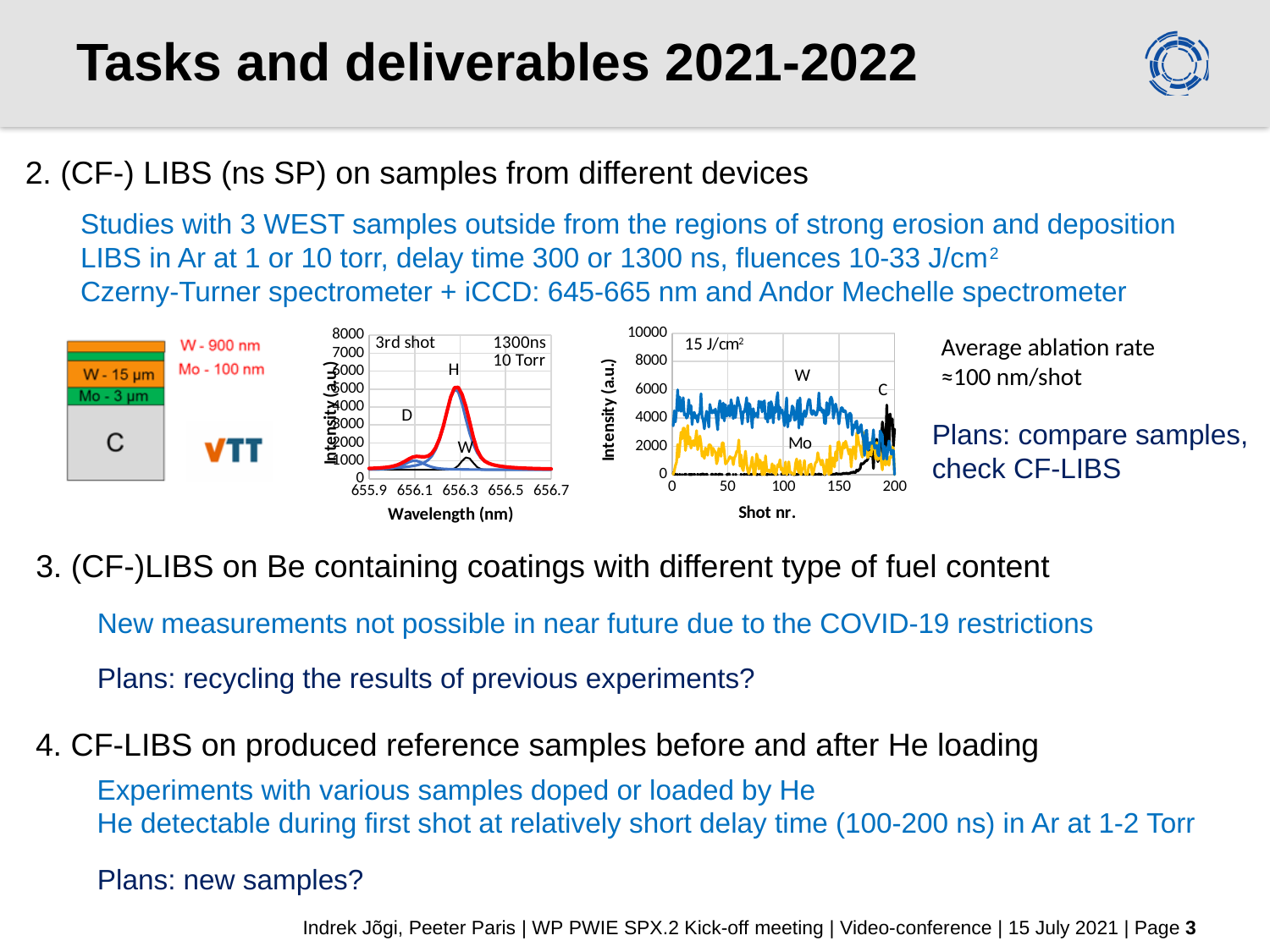
In the left chart (Intensity vs Wavelength), which labelled peak is the highest? H What kind of chart is the right chart (Intensity vs Shot nr.)? line chart In the left chart (Intensity vs Wavelength), is the peak value for W greater or less than 2000? less In the right chart (Intensity vs Shot nr.), is the value for W at shot 50 greater or less than 2000? greater In the right chart (Intensity vs Shot nr.), is the value for C at shot 50 greater or less than 2000? less In the right chart (Intensity vs Shot nr.), does the C signal rise or fall as the shot number increases toward 200? rise What kind of chart is the left chart (Intensity vs Wavelength)? line chart What is the x-axis label of the right chart? Shot nr. What is the x-axis label of the left chart? Wavelength (nm) In the right chart (Intensity vs Shot nr.), how many labelled series are shown? 3 In the left chart (Intensity vs Wavelength), how many labelled peaks (species) are marked? 3